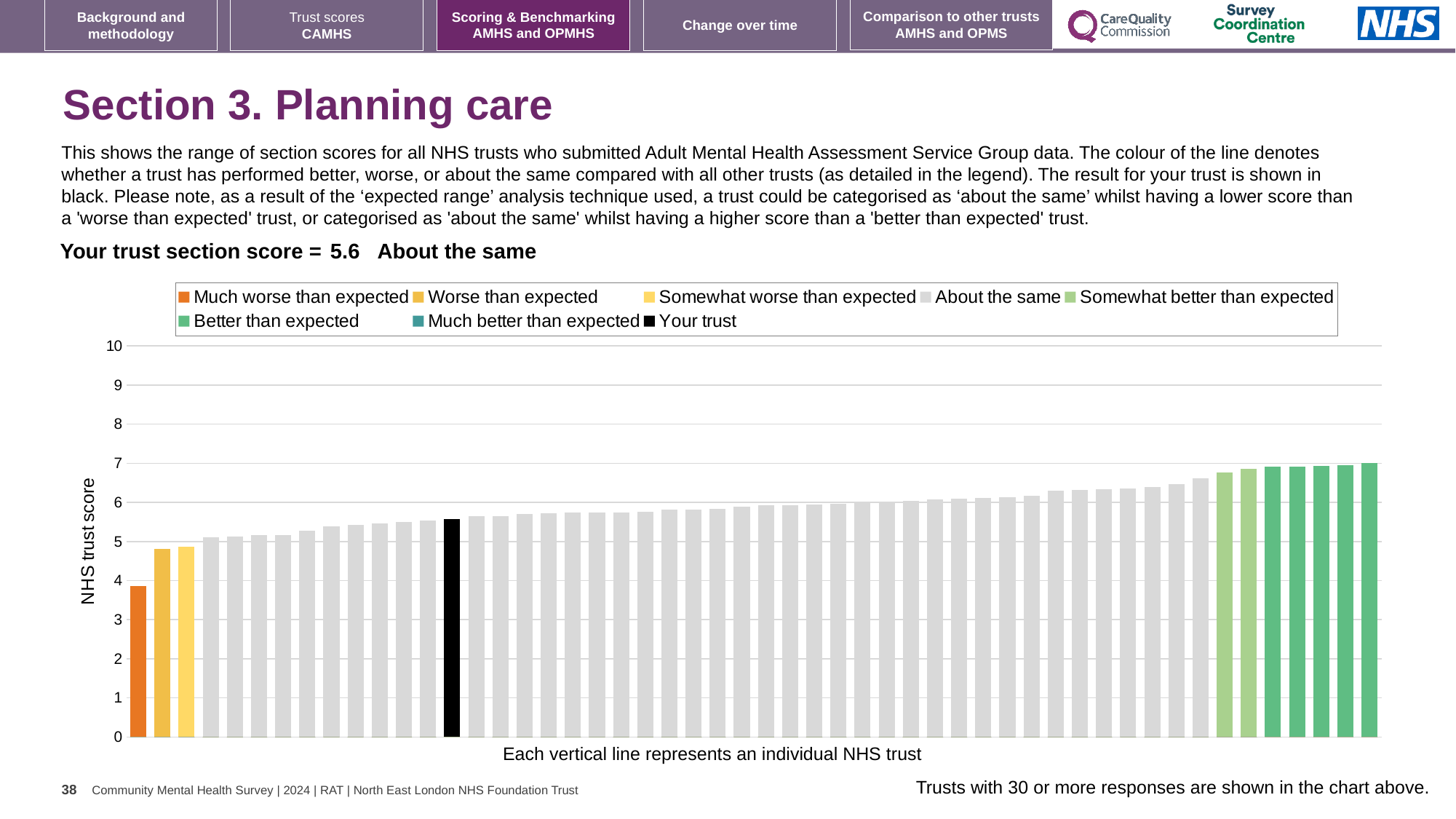
What is the label on the vertical axis of the chart? NHS trust score Is the value of the black 'Your trust' bar greater or less than 6? less Is the value of the orange 'Much worse than expected' bar greater or less than 5? less Do the bar values rise or fall from left to right along the x axis? rise Is the value of the black 'Your trust' bar greater or less than 5? greater How many entries does the chart legend list? 8 Which is larger: the black 'Your trust' bar or the orange 'Much worse than expected' bar? Your trust How many bars are coloured orange ('Much worse than expected') in the chart? 1 What kind of chart is shown on the slide? bar chart Which legend category does the lowest bar in the chart belong to? Much worse than expected What is the section score for your trust shown on the slide? 5.6